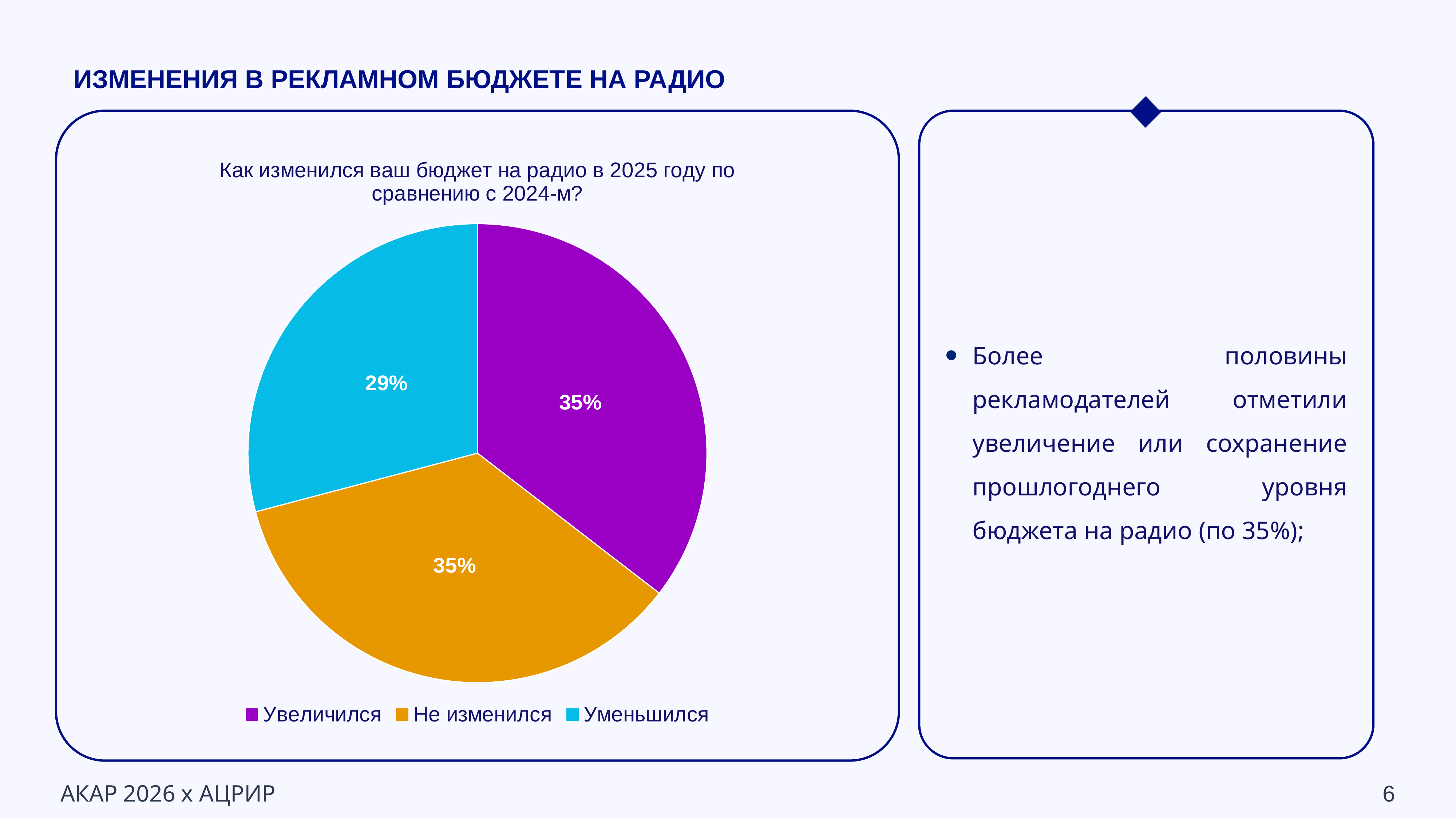
Which is larger: the share for Не изменился or the share for Уменьшился? Не изменился What share of the pie does the Уменьшился slice represent? 29% What percentage of respondents said their radio budget decreased (Уменьшился)? 29% Which colour represents the Не изменился category in the legend? Orange What percentage of respondents said their radio budget increased (Увеличился)? 35% What is the difference in percentage points between the Увеличился slice and the Уменьшился slice? 6 percentage points How many slices does the pie chart have? 3 What percentage of respondents said their radio budget did not change (Не изменился)? 35% What kind of chart is shown on the slide? Pie chart What is the title of the pie chart? Как изменился ваш бюджет на радио в 2025 году по сравнению с 2024-м? Is the value for Уменьшился greater or less than 30%? less Which category has the smallest share of the pie? Уменьшился